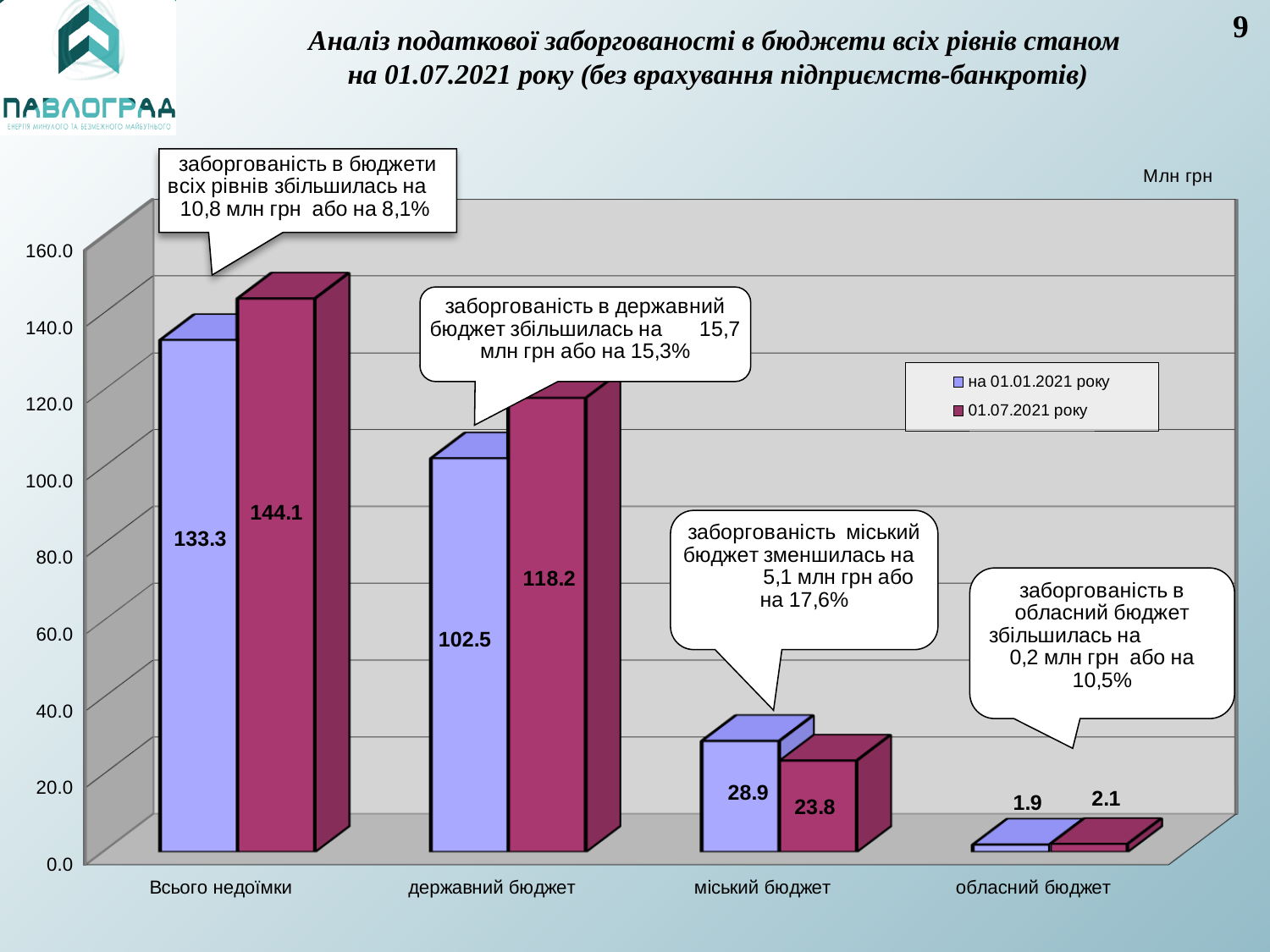
What type of chart is shown on the slide? bar chart What is the value for 'обласний бюджет' in the 'на 01.01.2021 року' series? 1.9 Which category has the lowest value in the '01.07.2021 року' series? обласний бюджет What is the value for 'державний бюджет' in the 'на 01.01.2021 року' series? 102.5 How many series does the legend list? 2 Which category has the highest value in the 'на 01.01.2021 року' series? Всього недоїмки For 'міський бюджет', which series has the larger value: 'на 01.01.2021 року' or '01.07.2021 року'? на 01.01.2021 року How many categories are shown on the x axis? 4 What unit is indicated in the top right corner of the chart? Млн грн What is the value for 'міський бюджет' in the '01.07.2021 року' series? 23.8 What is the difference between the '01.07.2021 року' and 'на 01.01.2021 року' values for 'державний бюджет'? 15.7 What is the value for 'Всього недоїмки' in the '01.07.2021 року' series? 144.1